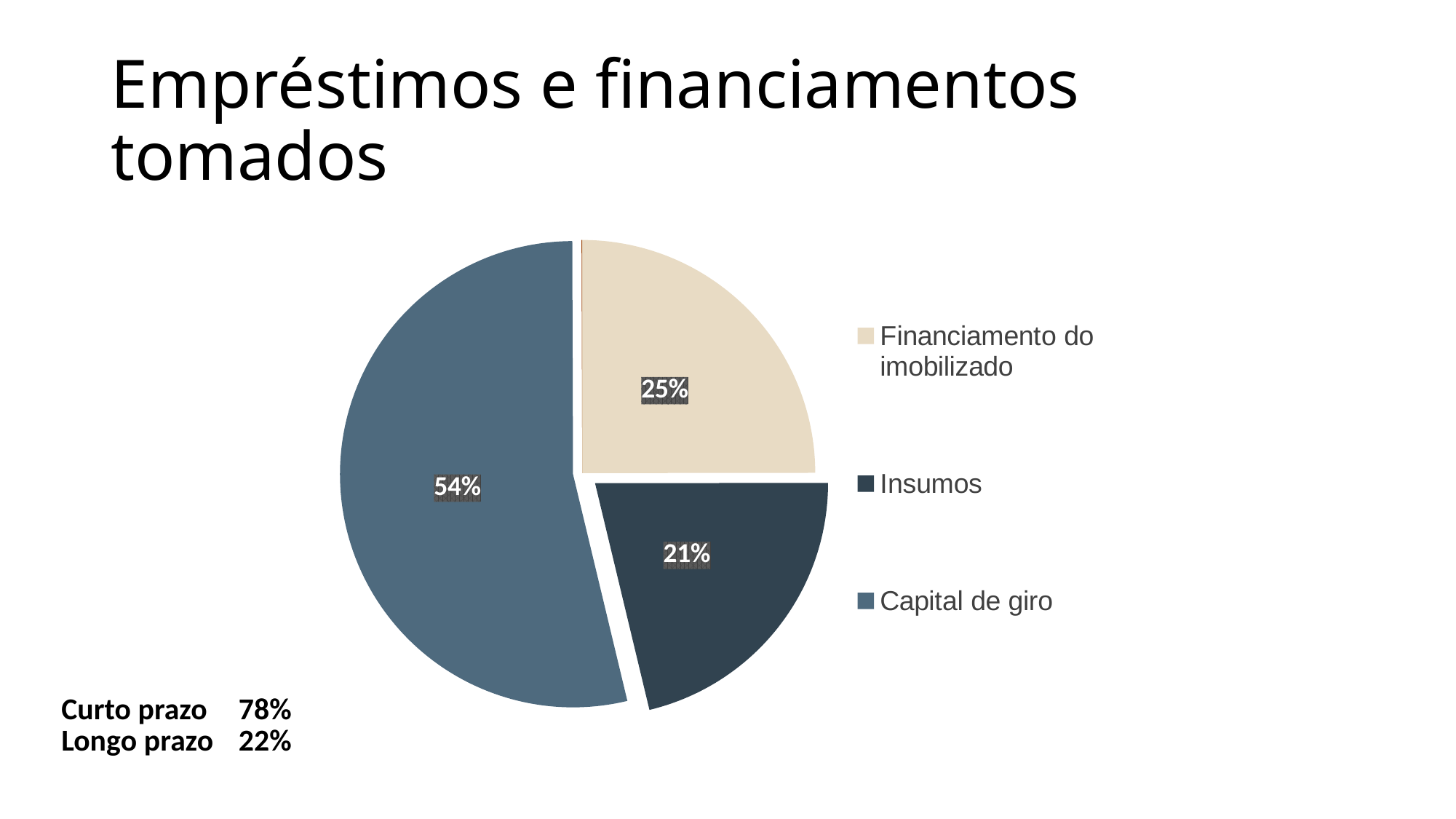
Which legend entry is shown in the beige colour? Financiamento do imobilizado What is the title of the slide containing the chart? Empréstimos e financiamentos tomados What share of the pie does Financiamento do imobilizado represent? 25% Which is larger, Financiamento do imobilizado or Insumos? Financiamento do imobilizado What share of the pie does Capital de giro represent? 54% What kind of chart is shown on the slide? Pie chart How many categories does the pie chart show? 3 What is the difference in percentage points between Capital de giro and Insumos? 33 Which category has the smallest slice of the pie? Insumos Which category has the largest slice of the pie? Capital de giro What is the difference in percentage points between Financiamento do imobilizado and Insumos? 4 What share of the pie does Insumos represent? 21%